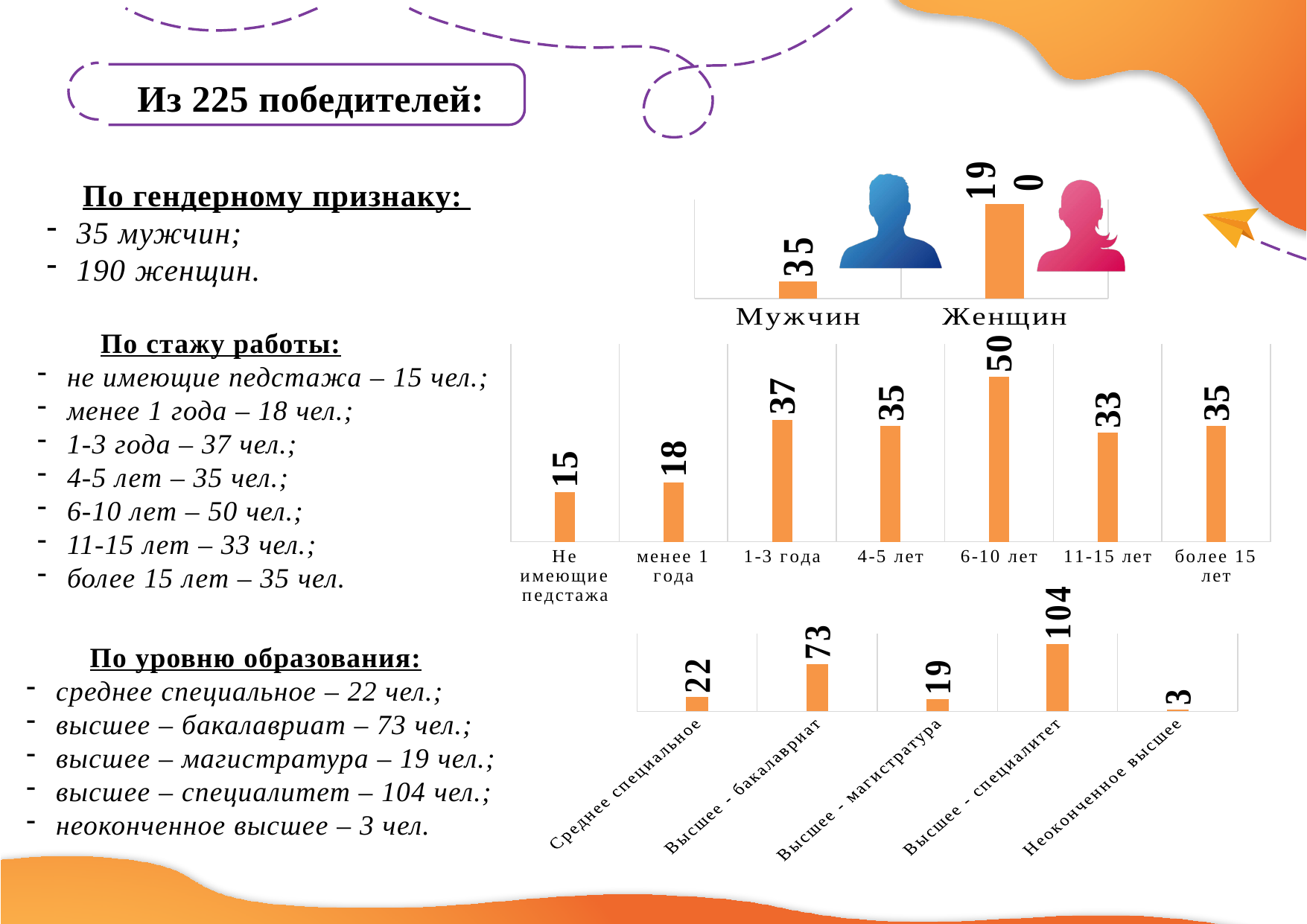
In the middle chart (work experience), how many categories are shown? 7 In the bottom chart (education), which category has the highest value? Высшее - специалитет In the middle chart (work experience), which is larger: the value for менее 1 года or the value for 11-15 лет? 11-15 лет In the top chart (gender), what is the value for Женщин? 190 In the top chart (gender), what is the value for Мужчин? 35 In the middle chart (work experience), which category has the highest value? 6-10 лет In the bottom chart (education), what is the value for Высшее - бакалавриат? 73 In the middle chart (work experience), what is the value for 1-3 года? 37 In the bottom chart (education), what is the difference between the values for Высшее - специалитет and Среднее специальное? 82 In the top chart (gender), what is the difference between the values for Женщин and Мужчин? 155 What type of chart is the bottom chart (education)? Bar chart In the middle chart (work experience), which category has the lowest value? Не имеющие педстажа